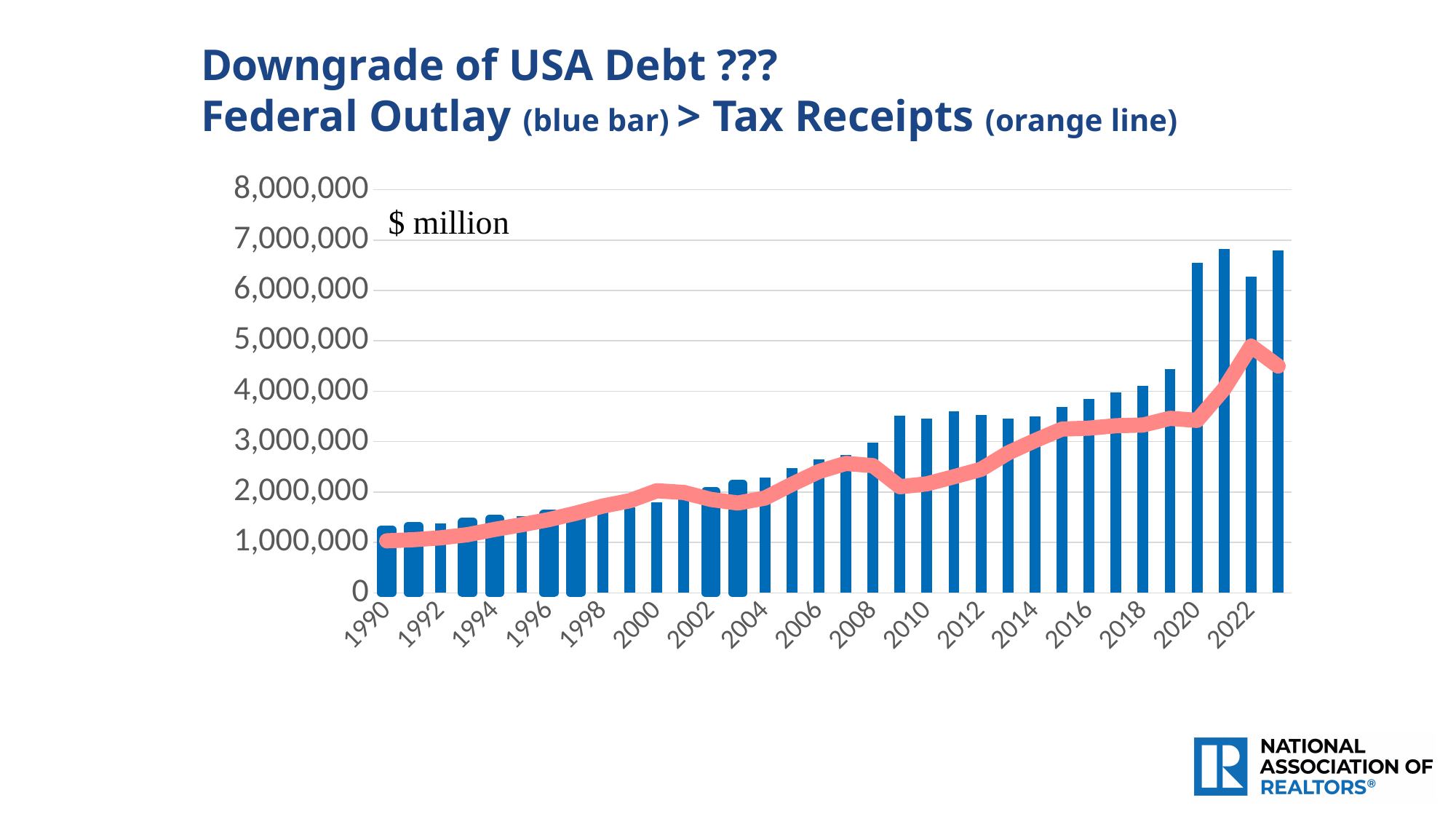
Which is larger, the Federal Outlay bar for 2021 or the Federal Outlay bar for 2022? 2021 Do the Federal Outlay bars generally rise or fall from 1990 to 2023? rise What kind of chart is shown on the slide? A combined bar and line chart In 2021, which is higher: the Federal Outlay (blue bar) or the Tax Receipts (orange line)? Federal Outlay (blue bar) What do the blue bars represent in the chart? Federal Outlay Is the Federal Outlay (blue bar) value for 2019 greater or less than 4,000,000? greater What unit is the vertical axis measured in, according to the label on the chart? $ million Is the Federal Outlay (blue bar) value for 2020 greater or less than 6,000,000? greater Is the Tax Receipts (orange line) value for 2007 greater or less than 3,000,000? less Which is larger, the Federal Outlay bar for 2019 or the Federal Outlay bar for 2020? 2020